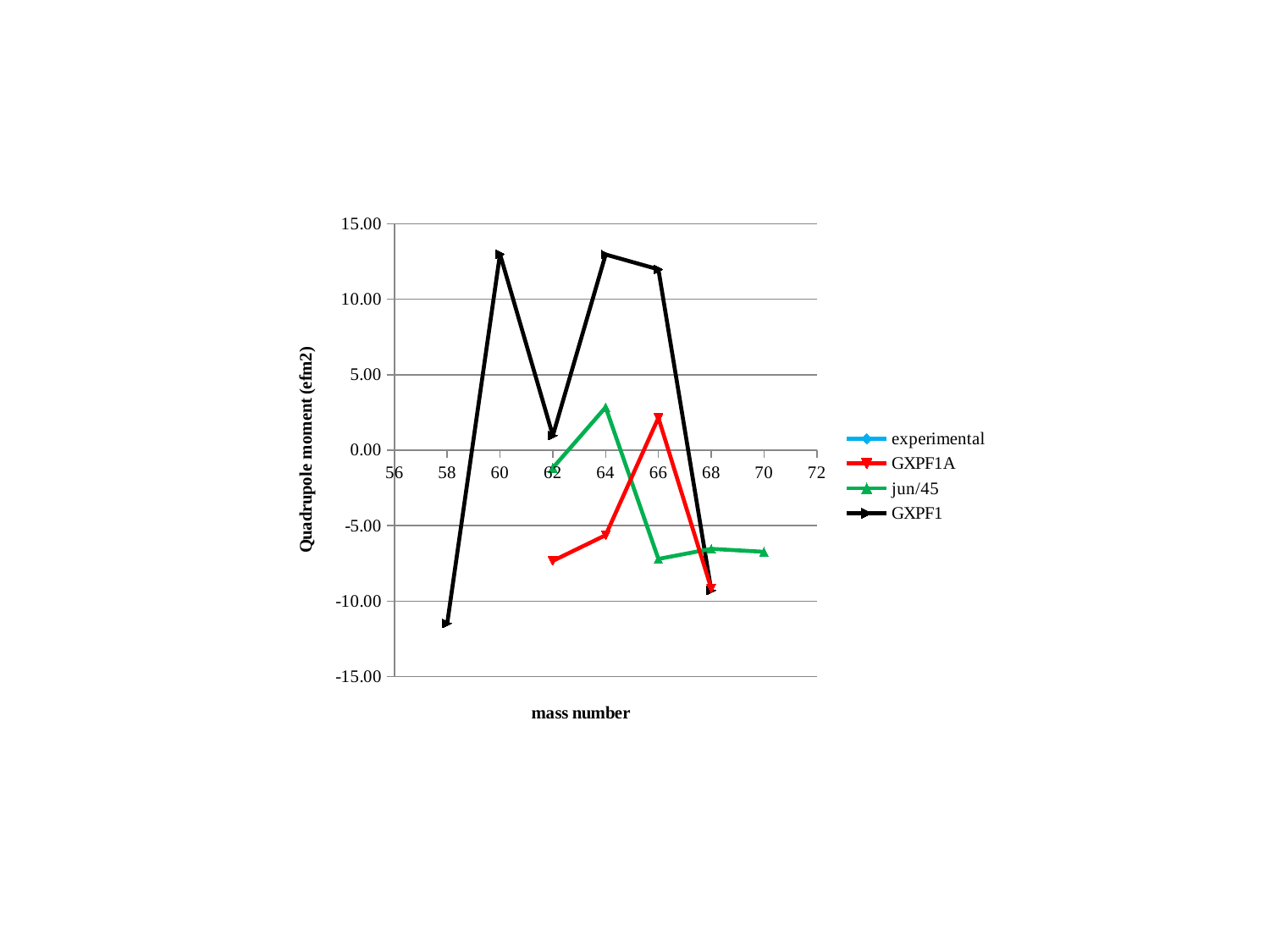
Does the GXPF1A series rise or fall from mass number 66 to 68? fall What is the label of the x axis? mass number At mass number 66, which series has the larger value, GXPF1 or GXPF1A? GXPF1 What is the label of the y axis? Quadrupole moment (efm2) How many series does the legend list? 4 What kind of chart is shown on the slide? line chart Is the GXPF1A value at mass number 62 greater or less than -5.00? less At mass number 64, which series has the larger value, jun/45 or GXPF1A? jun/45 Is the GXPF1 value at mass number 58 greater or less than -10.00? less Is the GXPF1A value at mass number 66 greater or less than 0.00? greater